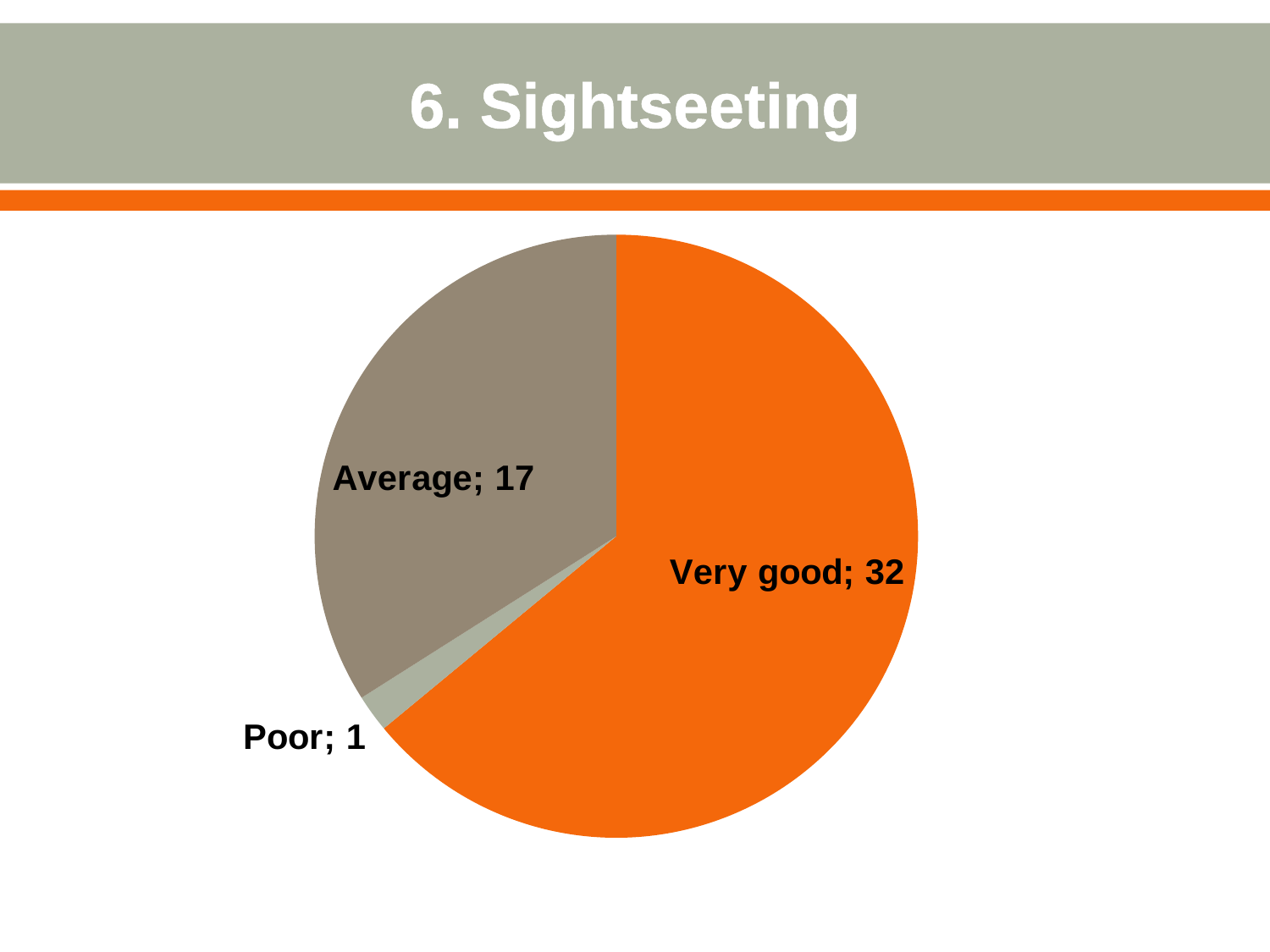
What kind of chart is shown on the slide? pie chart What is the difference between the values for Very good and Average? 15 What is the title of the slide containing the chart? 6. Sightseeting What is the difference between the values for Average and Poor? 16 What is the value for Average? 17 Which category has the smallest slice? Poor Which category has the largest slice? Very good What is the total of all slices in the pie chart? 50 Which is larger, the value for Average or the value for Poor? Average How many slices does the pie chart have? 3 What is the value for Poor? 1 What is the value for Very good? 32